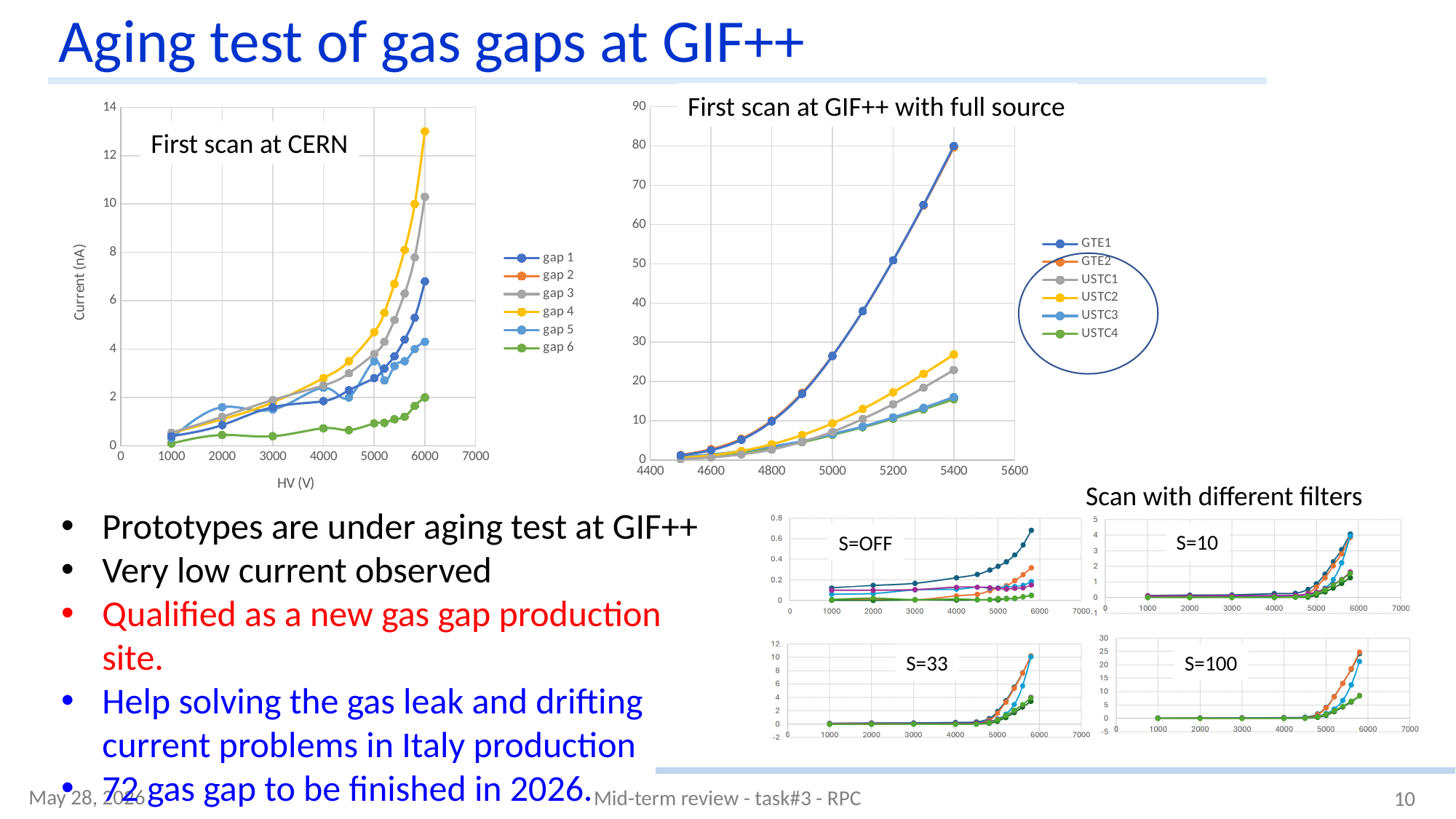
In the 'First scan at CERN' chart, which series has the lowest current at 6000 V? gap 6 In the 'First scan at GIF++ with full source' chart, does the GTE1 series rise or fall as the x-axis value increases? rise In the 'First scan at CERN' chart, is the value for gap 4 at 6000 V greater or less than 12? greater In the 'First scan at CERN' chart, what is the label of the x axis? HV (V) In the 'First scan at CERN' chart, is the value for gap 6 at 6000 V greater or less than 4? less In the 'First scan at CERN' chart, which series reaches the highest current at 6000 V? gap 4 What kind of chart is the 'First scan at GIF++ with full source' chart? line chart In the 'First scan at GIF++ with full source' chart, is the value for USTC4 at 5400 greater or less than 20? less In the 'First scan at CERN' chart, how many series does the legend list? 6 In the 'First scan at GIF++ with full source' chart, how many series does the legend list? 6 In the 'First scan at CERN' chart, what is the label of the y axis? Current (nA)